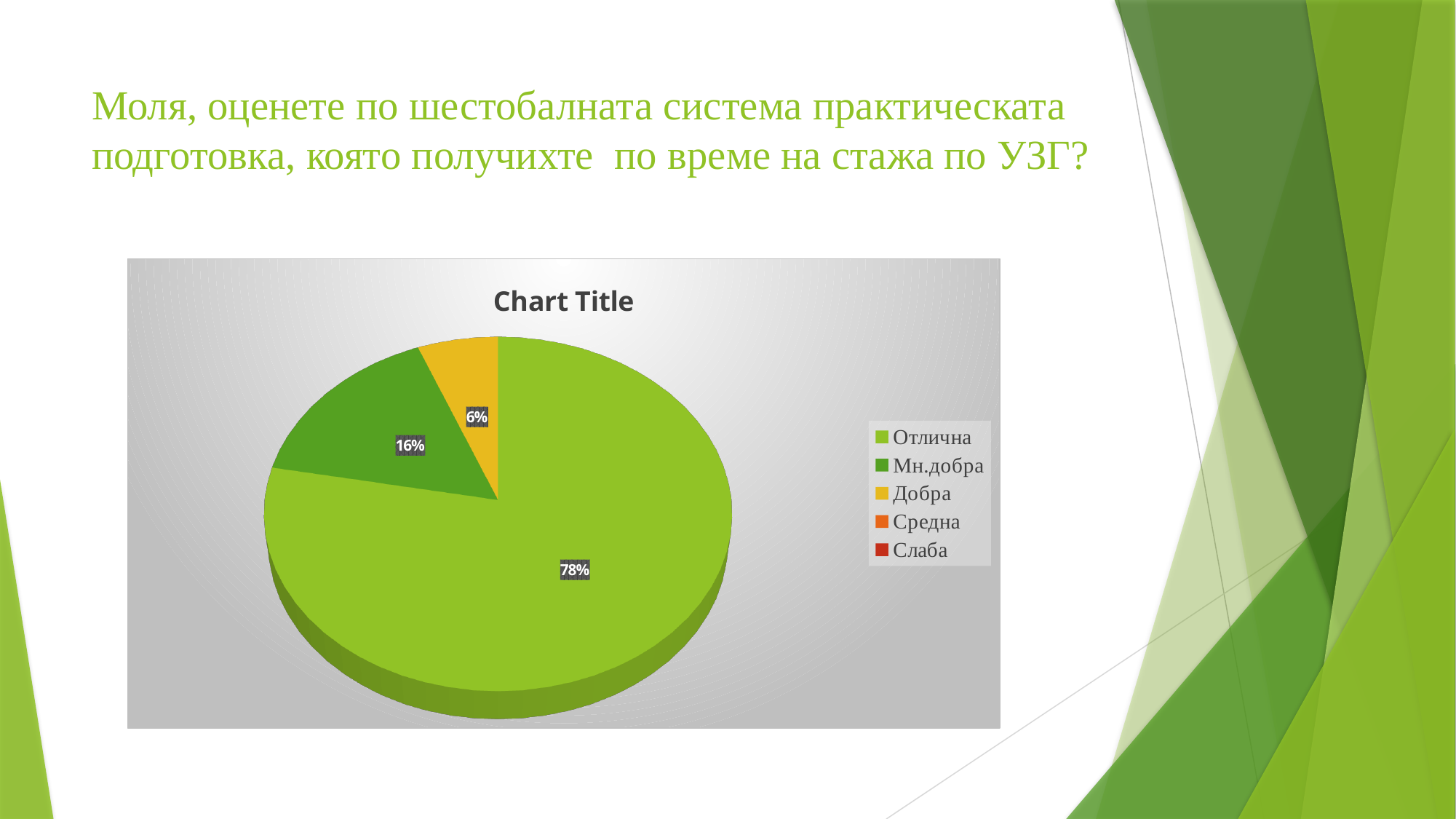
What share of the pie does Отлична have? 78% Which is larger, the slice for Мн.добра or the slice for Добра? Мн.добра Which category has the largest slice of the pie? Отлична What share of the pie does Добра have? 6% What is the difference between the shares of Отлична and Мн.добра? 62% What is the difference between the shares of Мн.добра and Добра? 10% How many slices have a percentage label shown on the pie? 3 How many entries does the legend list? 5 What kind of chart is shown on the slide? pie chart What is the title shown on the chart? Chart Title Which of the labelled slices is the smallest? Добра What share of the pie does Мн.добра have? 16%